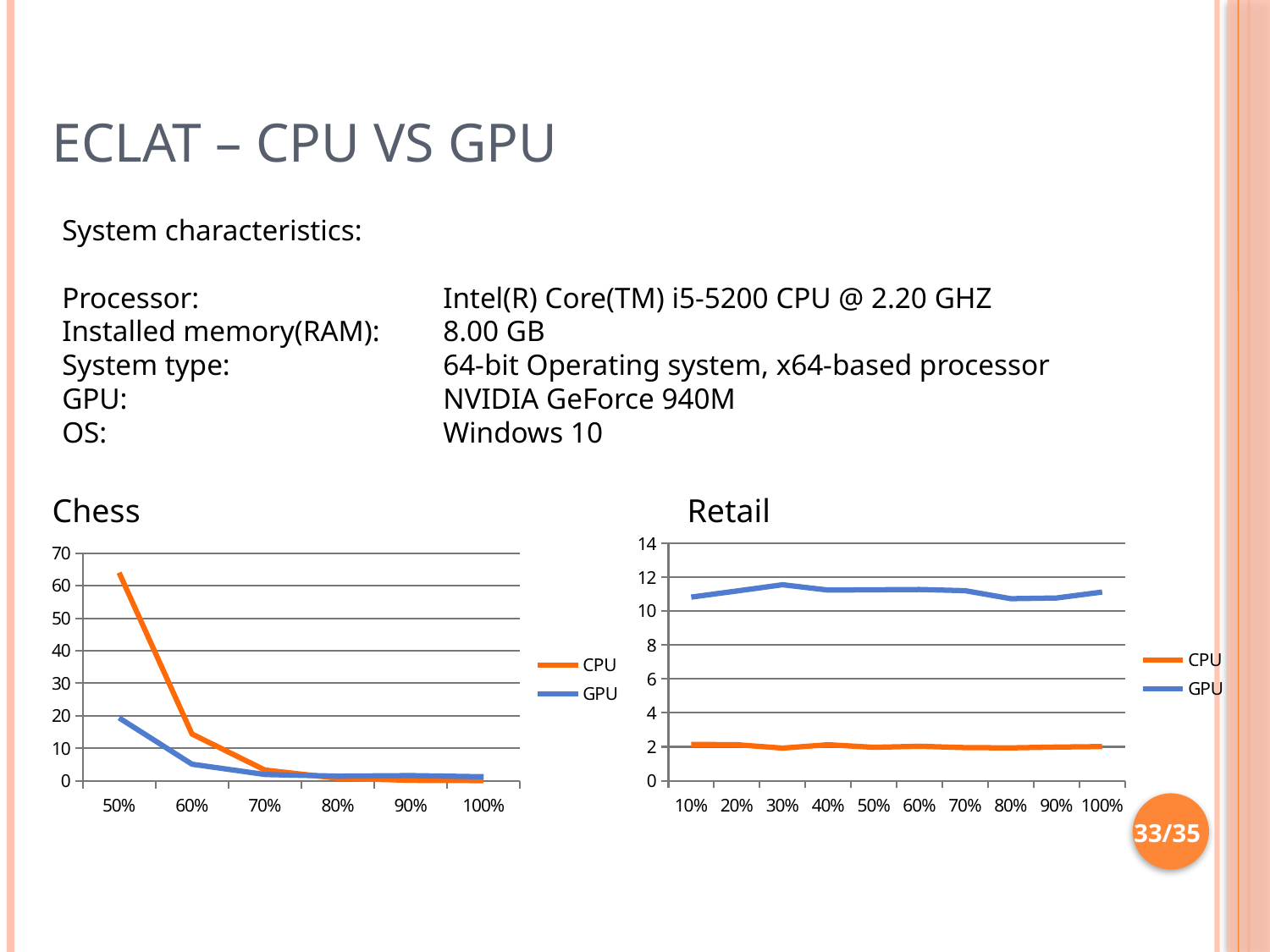
In the Chess chart, does the CPU line rise or fall as the x axis goes from 50% to 100%? fall How many series does the legend of the Retail chart list? 2 In the Chess chart, is the CPU value at 50% greater or less than 60? greater In the Retail chart, which series has the larger value at 50%, CPU or GPU? GPU In the Retail chart, is the GPU value at 30% greater or less than 10? greater In the Chess chart, at which x-axis category is the CPU value highest? 50% What kind of chart is the Chess chart? line chart In the Chess chart, is the CPU value at 60% greater or less than 10? greater How many x-axis categories does the Chess chart have? 6 In the Chess chart, which series has the larger value at 50%, CPU or GPU? CPU How many x-axis categories does the Retail chart have? 10